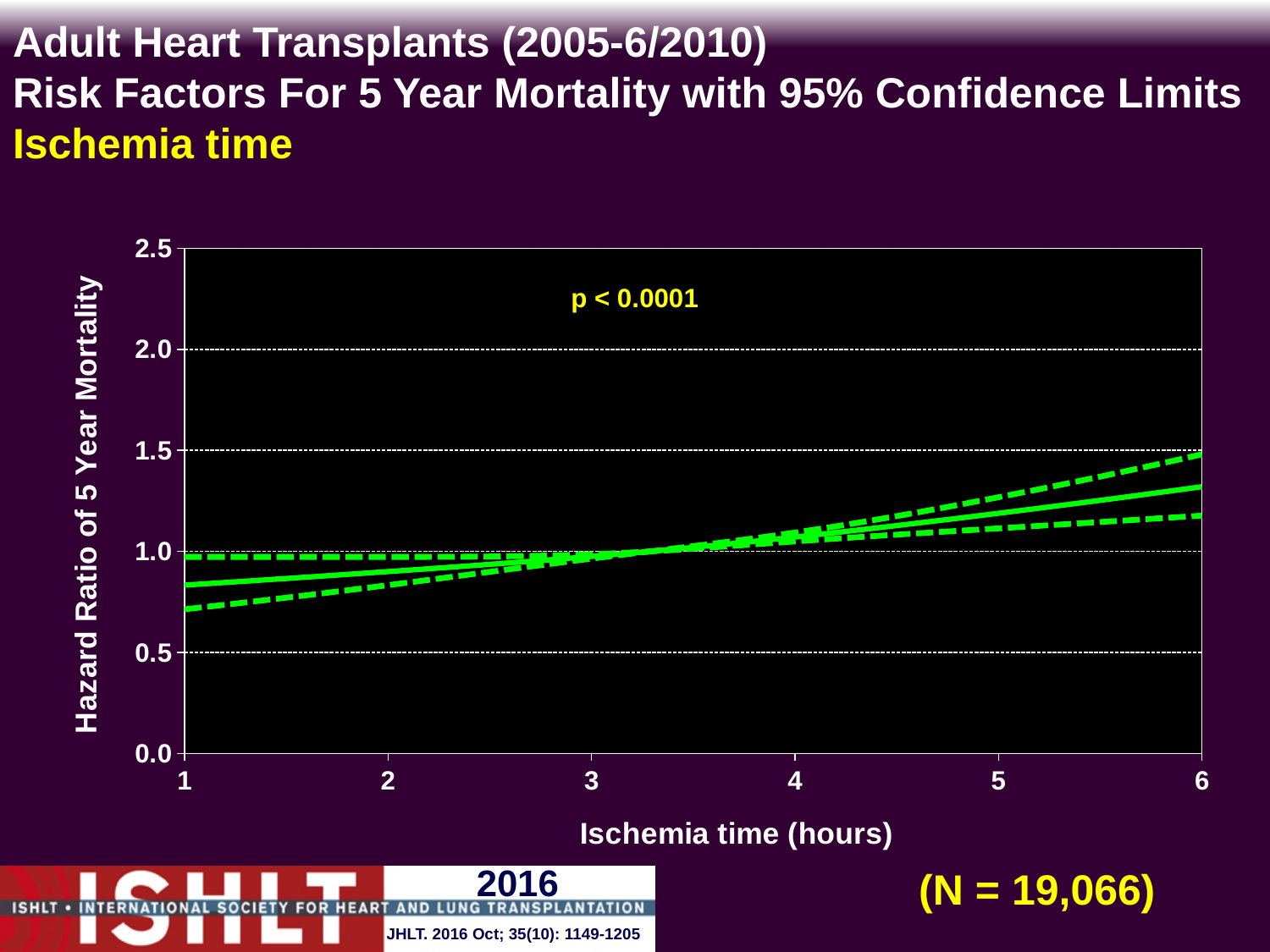
Is the hazard ratio (solid line) at an ischemia time of 1 hour greater or less than 1.0? less What kind of chart is shown on the slide? line chart Is the lower 95% confidence limit (lower dashed line) at an ischemia time of 1 hour greater or less than 0.5? greater How many labelled tick marks are on the x axis (Ischemia time)? 6 Is the hazard ratio (solid line) at an ischemia time of 5 hours greater or less than 1.0? greater Does the hazard ratio of 5 year mortality rise or fall as ischemia time increases from 1 to 6 hours? rise What p-value is printed on the chart? p < 0.0001 What sample size (N) is shown on the slide? N = 19,066 How many lines are plotted on the chart (solid line plus dashed confidence limits)? 3 Which has the larger hazard ratio on the solid line: an ischemia time of 1 hour or 6 hours? 6 hours